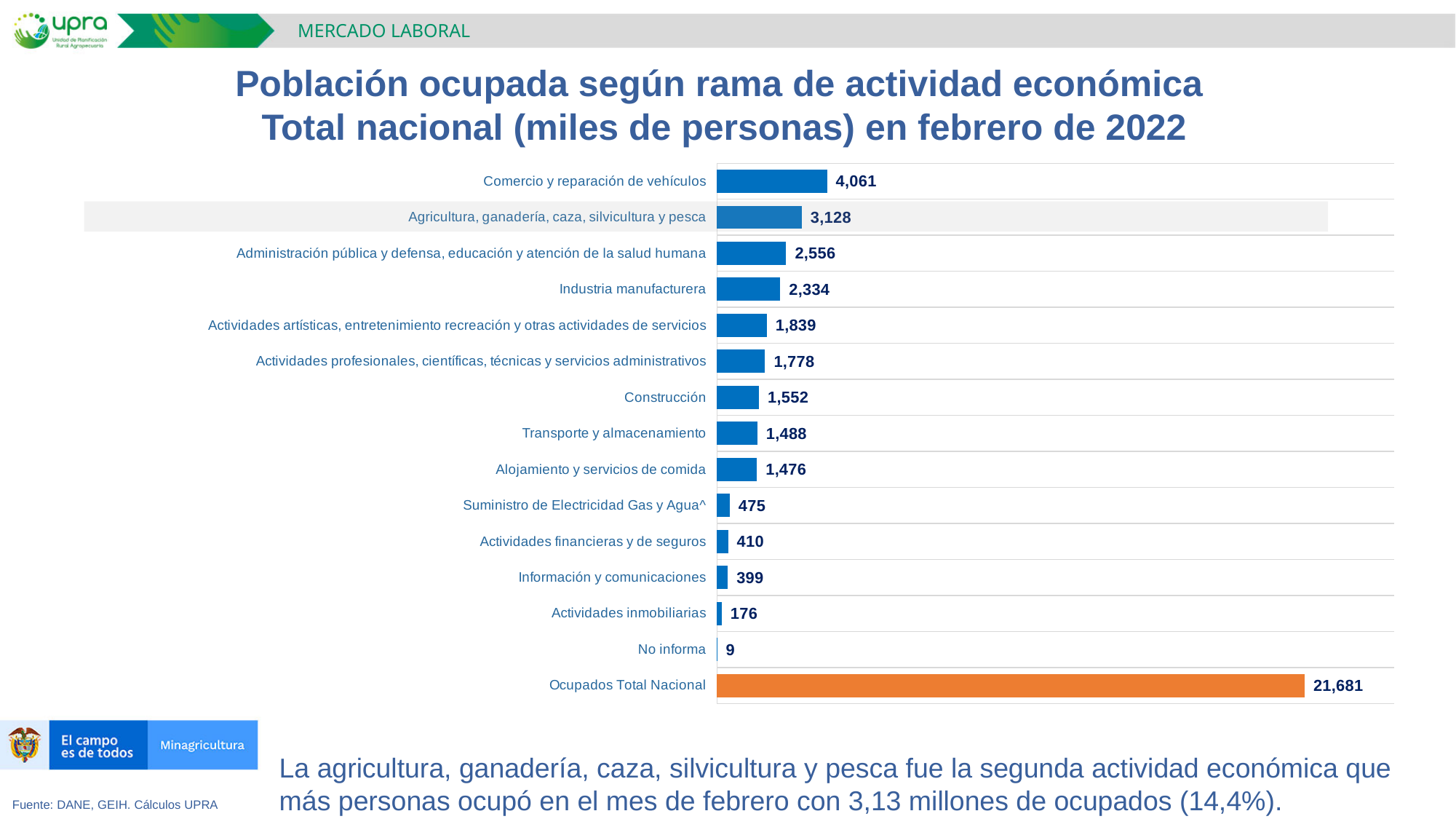
Which bar is coloured orange instead of blue? Ocupados Total Nacional What is the value for Ocupados Total Nacional? 21,681 Excluding the Ocupados Total Nacional bar, which economic activity has the highest value? Comercio y reparación de vehículos What is the value for Actividades inmobiliarias? 176 What is the value for Agricultura, ganadería, caza, silvicultura y pesca? 3,128 What is the value for Comercio y reparación de vehículos? 4,061 Which is larger, Construcción or Transporte y almacenamiento? Construcción What is the difference between Comercio y reparación de vehículos and Agricultura, ganadería, caza, silvicultura y pesca? 933 What is the difference between Industria manufacturera and Construcción? 782 How many bars are shown in the chart? 15 What kind of chart is shown on the slide? Bar chart Which category has the lowest value? No informa